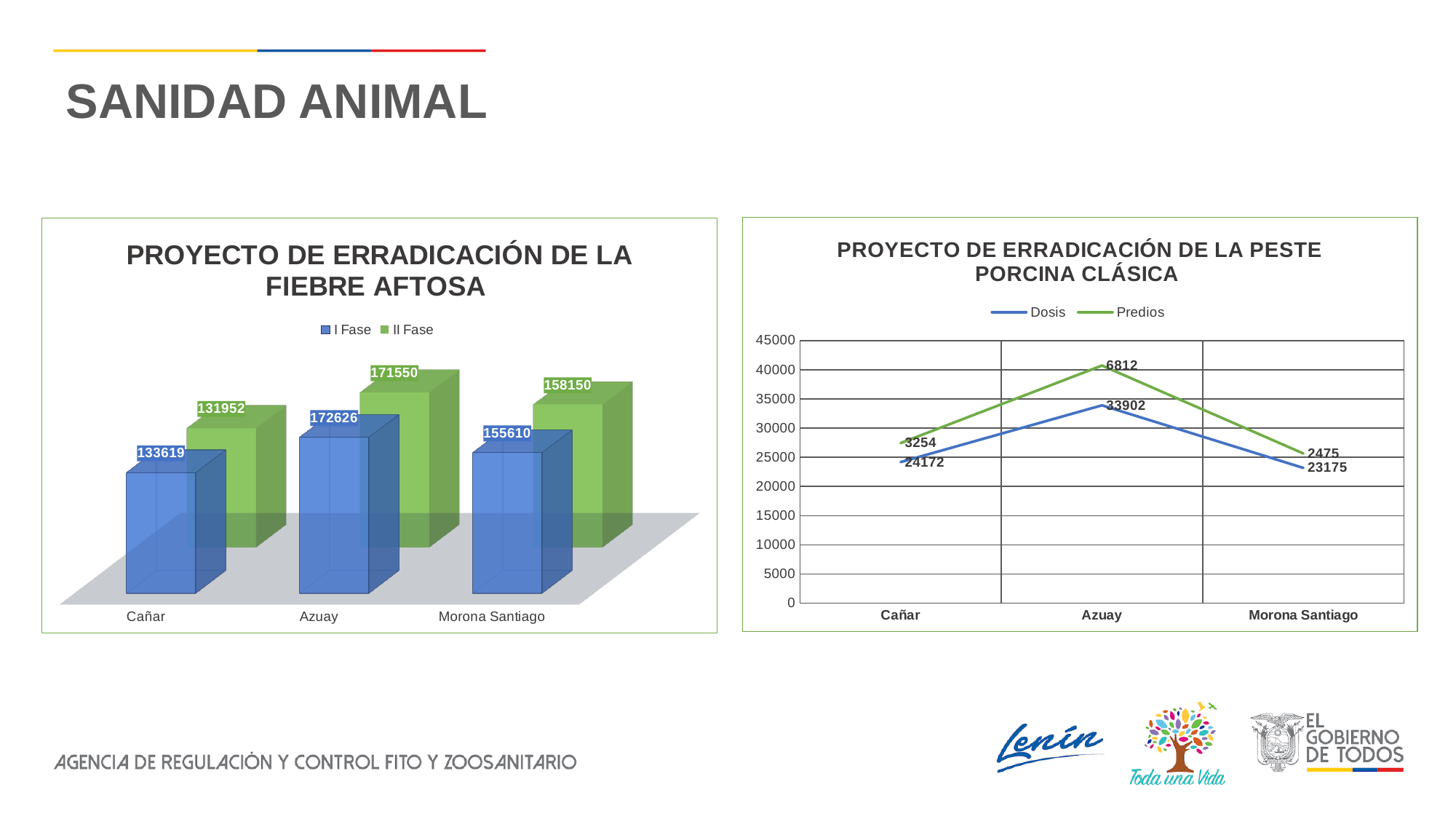
In the PROYECTO DE ERRADICACIÓN DE LA PESTE PORCINA CLÁSICA chart, which province has the lowest Dosis value? Morona Santiago In the PROYECTO DE ERRADICACIÓN DE LA FIEBRE AFTOSA chart, which province has the lowest I Fase value? Cañar In the PROYECTO DE ERRADICACIÓN DE LA FIEBRE AFTOSA chart, what is the II Fase value for Morona Santiago? 158150 What kind of chart is the PROYECTO DE ERRADICACIÓN DE LA PESTE PORCINA CLÁSICA chart? Line chart In the PROYECTO DE ERRADICACIÓN DE LA FIEBRE AFTOSA chart, what is the I Fase value for Azuay? 172626 What kind of chart is the PROYECTO DE ERRADICACIÓN DE LA FIEBRE AFTOSA chart? Bar chart In the PROYECTO DE ERRADICACIÓN DE LA FIEBRE AFTOSA chart, what is the difference between the I Fase and II Fase values for Cañar? 1667 In the PROYECTO DE ERRADICACIÓN DE LA FIEBRE AFTOSA chart, which province has the highest II Fase value? Azuay In the PROYECTO DE ERRADICACIÓN DE LA PESTE PORCINA CLÁSICA chart, what is the difference between the Dosis values for Azuay and Cañar? 9730 In the PROYECTO DE ERRADICACIÓN DE LA PESTE PORCINA CLÁSICA chart, what is the Dosis value for Azuay? 33902 In the PROYECTO DE ERRADICACIÓN DE LA FIEBRE AFTOSA chart, how many series does the legend list? 2 In the PROYECTO DE ERRADICACIÓN DE LA PESTE PORCINA CLÁSICA chart, what is the Predios value for Morona Santiago? 2475